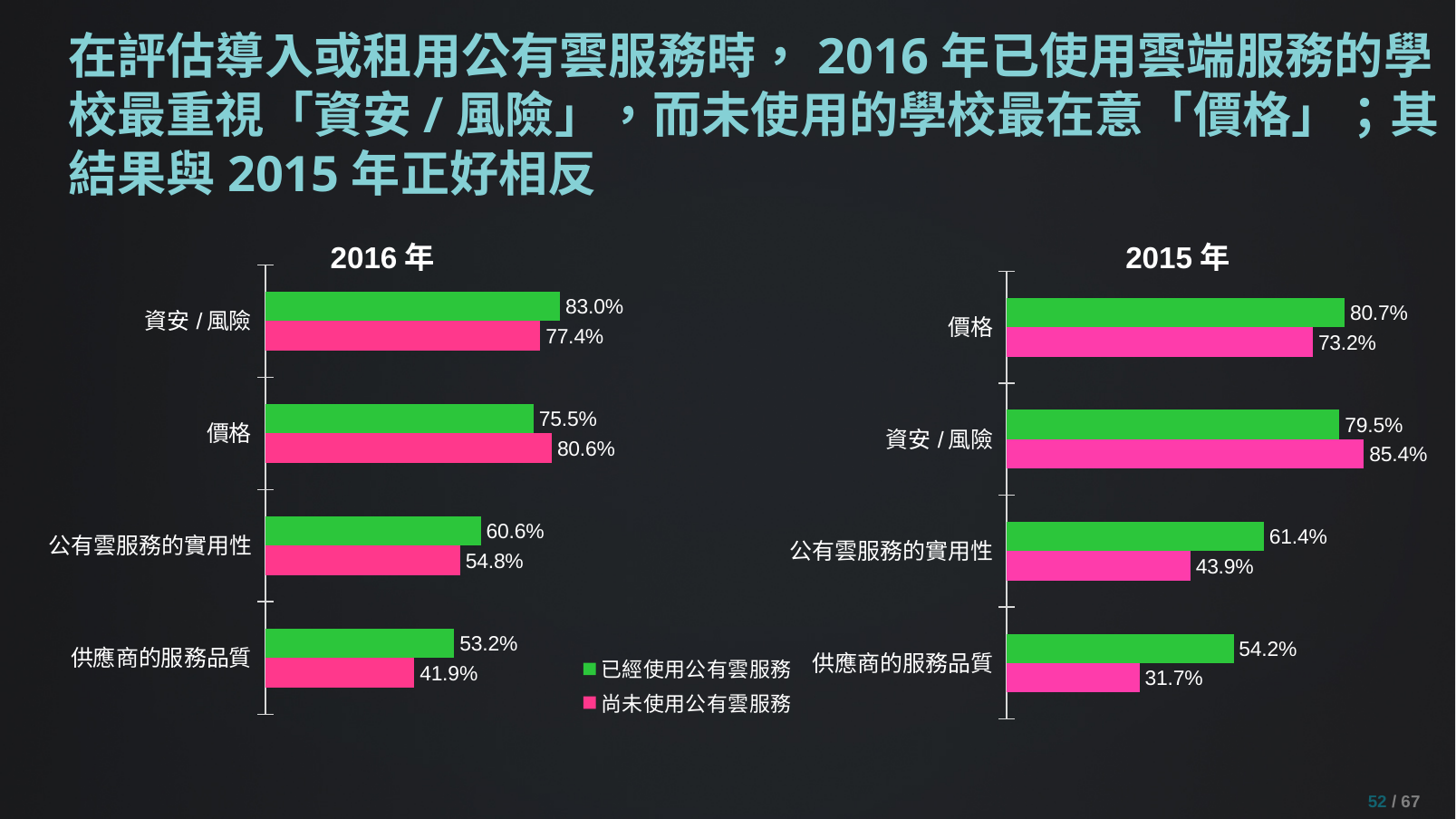
In the 2015 年 chart, what is the value for 供應商的服務品質 for 已經使用公有雲服務? 54.2% In the 2016 年 chart, what is the value for 資安 / 風險 for 已經使用公有雲服務? 83.0% In the 2015 年 chart, which series has the larger value for 價格? 已經使用公有雲服務 How many categories does the 2016 年 chart show? 4 In the 2015 年 chart, what is the value for 資安 / 風險 for 尚未使用公有雲服務? 85.4% In the 2016 年 chart, what is the value for 價格 for 尚未使用公有雲服務? 80.6% How many series does the legend list? 2 In the 2015 年 chart, what is the difference between the two series for 公有雲服務的實用性? 17.5% In the 2016 年 chart, what is the difference between the two series for 供應商的服務品質? 11.3% In the 2015 年 chart, which category has the lowest value for 尚未使用公有雲服務? 供應商的服務品質 In the 2016 年 chart, which category has the highest value for 已經使用公有雲服務? 資安 / 風險 What type of chart is the 2015 年 chart? Bar chart